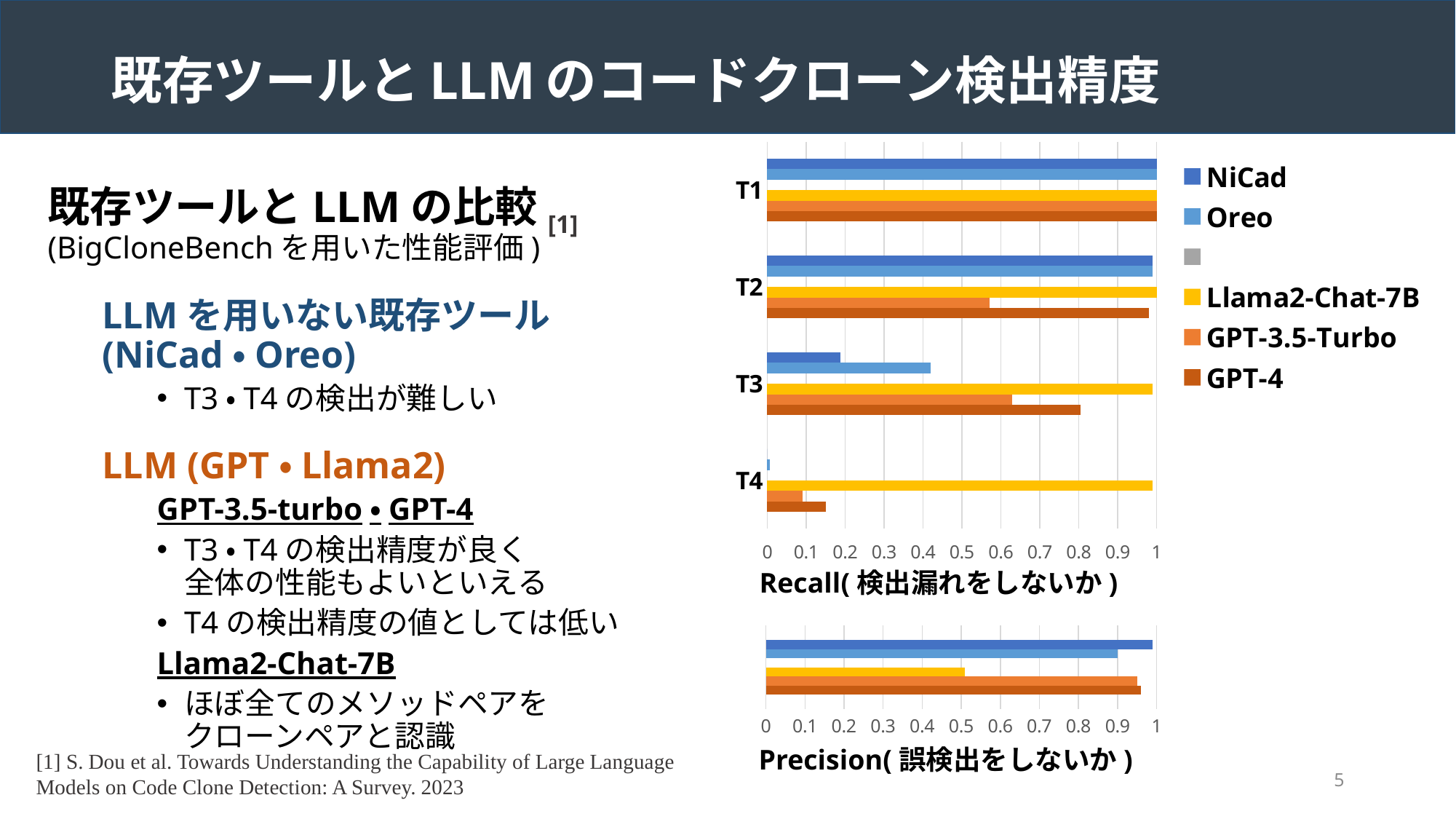
In the Recall chart, is the value for GPT-4 at T3 greater or less than 0.7? greater In the Recall chart, is the value for Llama2-Chat-7B at T4 greater or less than 0.9? greater In the Precision chart, which series has the lowest value? Llama2-Chat-7B In the Precision chart, is the value for Llama2-Chat-7B greater or less than 0.6? less In the Recall chart, which series has the highest value at T4? Llama2-Chat-7B In the Recall chart, which series has the lowest value at T3? NiCad In the Recall chart at T3, which is larger: GPT-4 or GPT-3.5-Turbo? GPT-4 How many categories (T1–T4) does the Recall chart show? 4 In the Precision chart, which is larger: NiCad or Oreo? NiCad What kind of chart is the Recall chart? bar chart